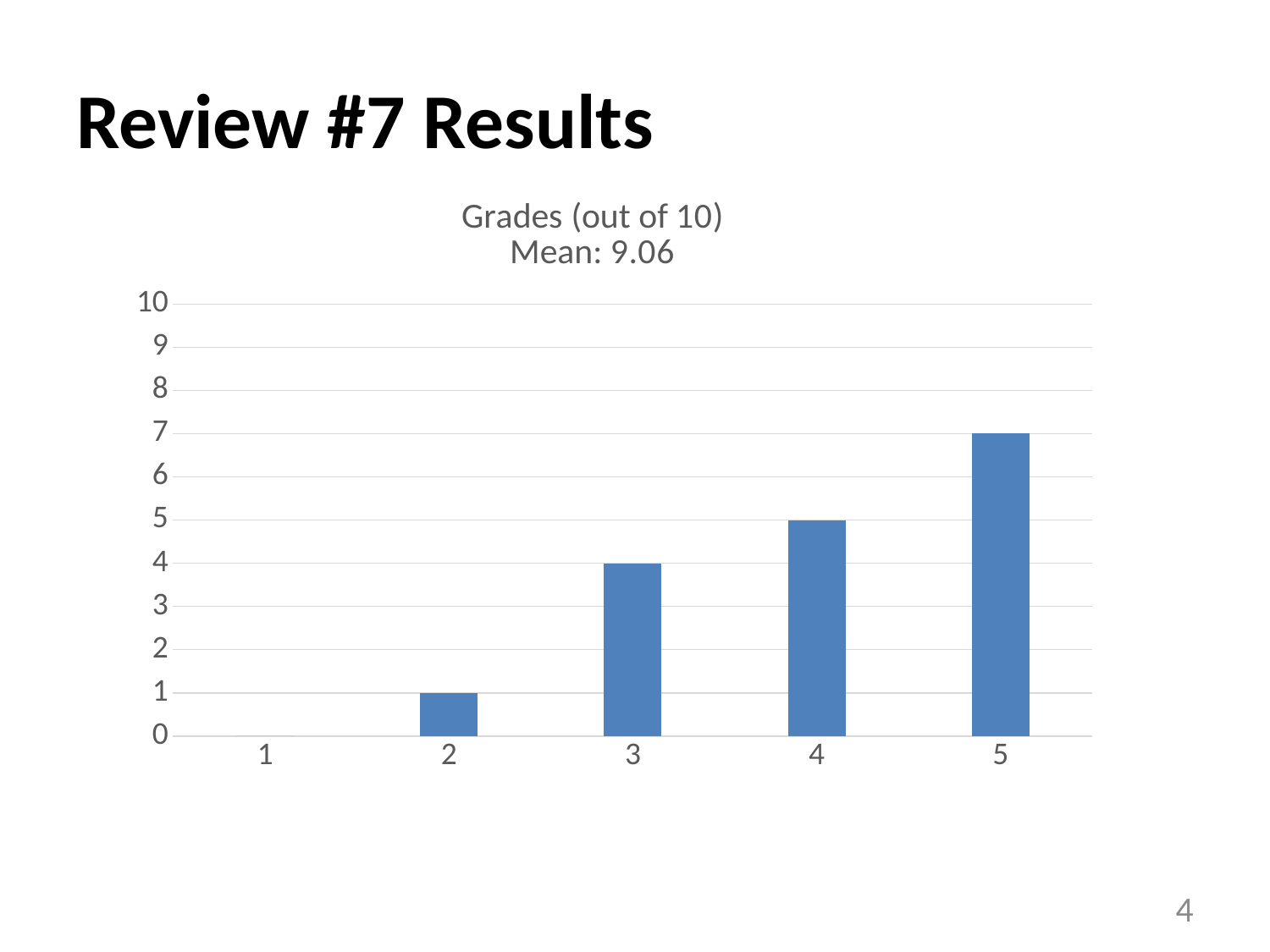
How many categories are shown on the x axis? 5 Do the values rise or fall from category 1 to category 5? rise What mean value is stated in the chart title? 9.06 Which category has the highest value? 5 What is the value for category 5? 7 What is the difference between the values for category 5 and category 4? 2 Which category has the lowest value? 1 What is the value for category 3? 4 What is the value for category 2? 1 What is the title of the chart? Grades (out of 10) Mean: 9.06 Which is larger, the value for category 3 or the value for category 4? category 4 What kind of chart is shown on the slide? bar chart